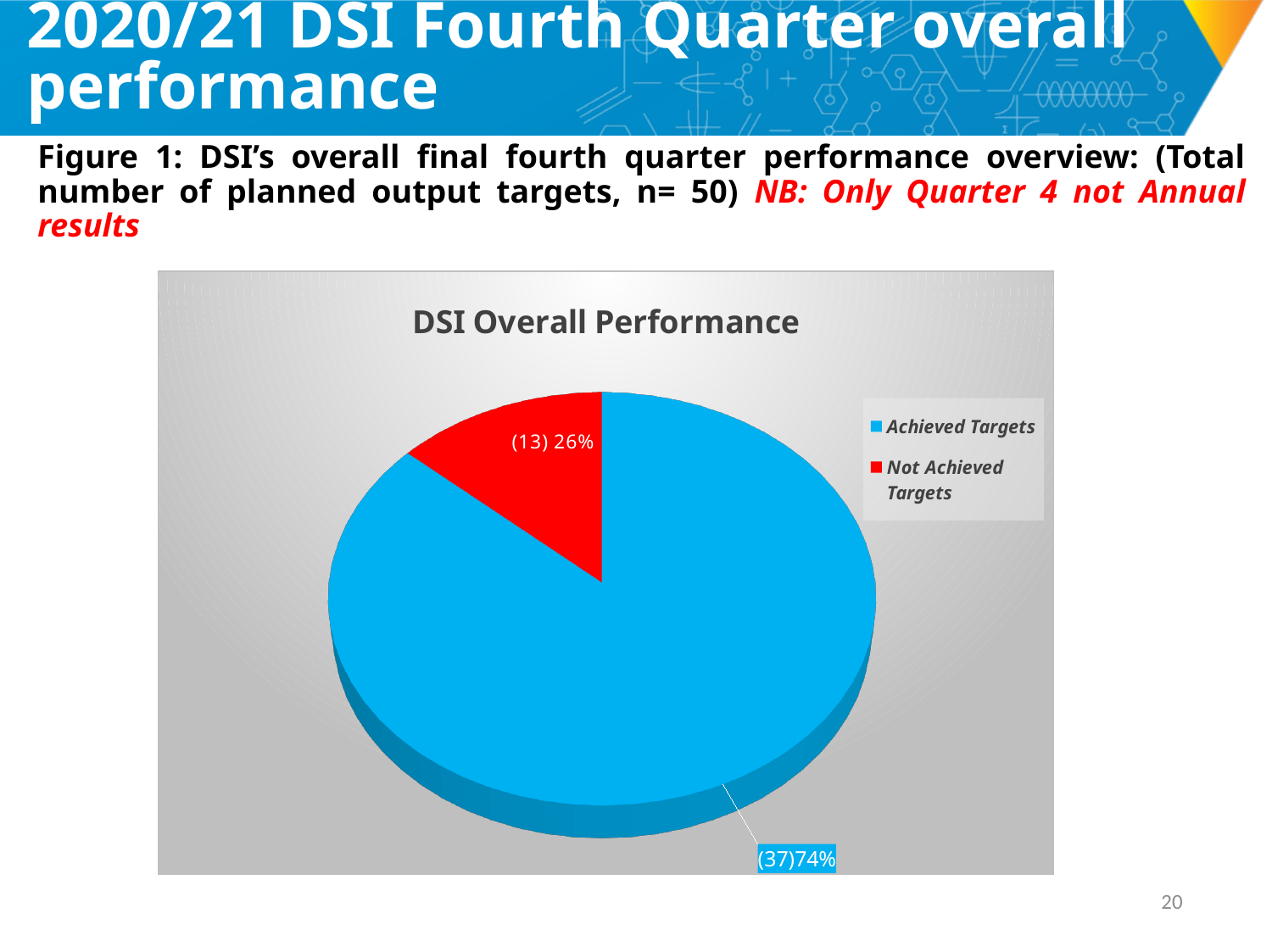
What percentage of the pie is Achieved Targets? 74% Which slice is the smallest? Not Achieved Targets Which is larger, Achieved Targets or Not Achieved Targets? Achieved Targets How many targets were achieved according to the chart's data label? 37 How many targets were not achieved according to the chart's data label? 13 What colour represents Not Achieved Targets in the chart? Red What percentage of the pie is Not Achieved Targets? 26% What is the difference in number of targets between Achieved Targets and Not Achieved Targets? 24 What is the title of the chart? DSI Overall Performance Which slice is the largest? Achieved Targets What kind of chart is shown on the slide? Pie chart How many series does the legend list? 2